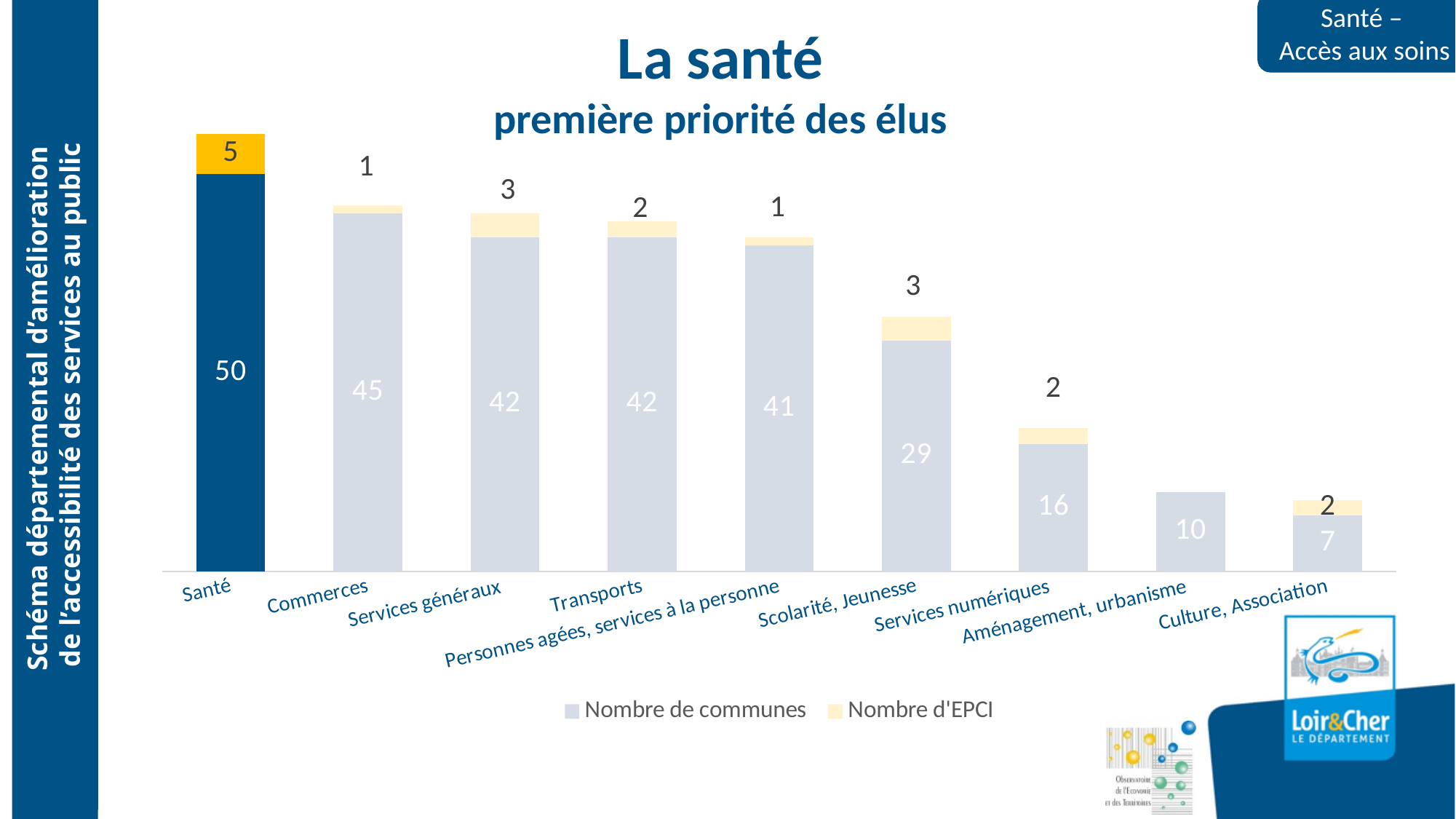
What are the two series named in the legend? Nombre de communes and Nombre d'EPCI Which category has the highest number of communes? Santé Which category has the lowest number of communes? Culture, Association What kind of chart is shown on the slide? Stacked bar chart How many series does the legend list? 2 Which has more communes, Services numériques or Aménagement, urbanisme? Services numériques What is the total of the stacked bar for Santé (communes plus EPCI)? 55 What is the difference in the number of communes between Santé and Commerces? 5 What is the number of communes for Scolarité, Jeunesse? 29 What is the number of EPCI for Services généraux? 3 What is the number of communes for Santé? 50 How many categories are shown on the x axis? 9